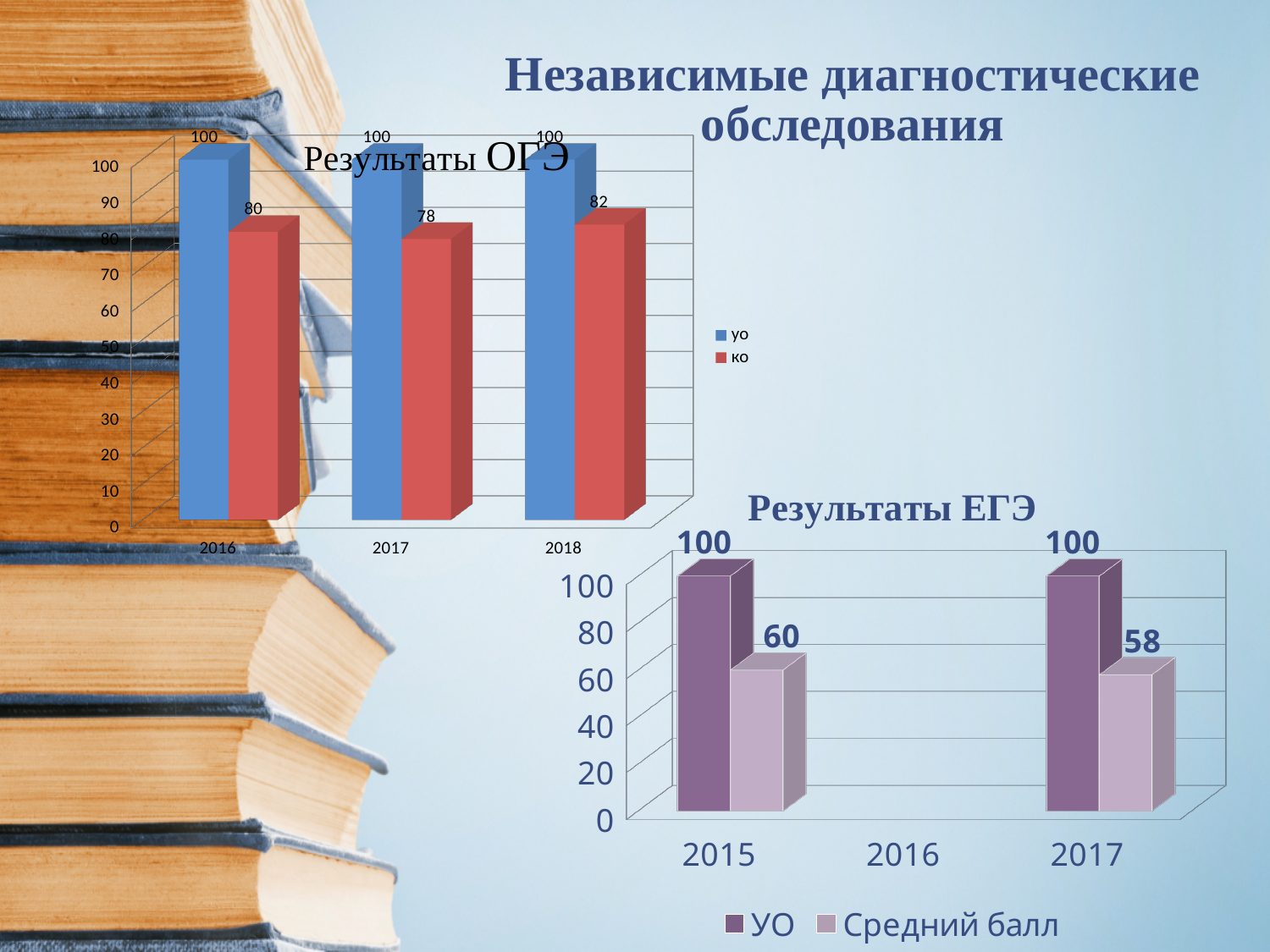
In the 'Результаты ОГЭ' chart, how many series does the legend list? 2 In the 'Результаты ЕГЭ' chart, is Средний балл larger in 2015 or in 2017? 2015 In the 'Результаты ЕГЭ' chart, how many years are shown on the x axis? 3 In the 'Результаты ЕГЭ' chart, what is the difference between УО and Средний балл in 2015? 40 What kind of chart is 'Результаты ЕГЭ'? Bar chart In the 'Результаты ЕГЭ' chart, what is the value of Средний балл for 2017? 58 In the 'Результаты ОГЭ' chart, what is the value of уо for 2018? 100 In the 'Результаты ЕГЭ' chart, what is the value of УО for 2015? 100 In the 'Результаты ОГЭ' chart, which year has the highest ко value? 2018 In the 'Результаты ОГЭ' chart, what is the difference between уо and ко in 2016? 20 In the 'Результаты ОГЭ' chart, what is the value of ко for 2017? 78 In the 'Результаты ОГЭ' chart, which year has the lowest ко value? 2017